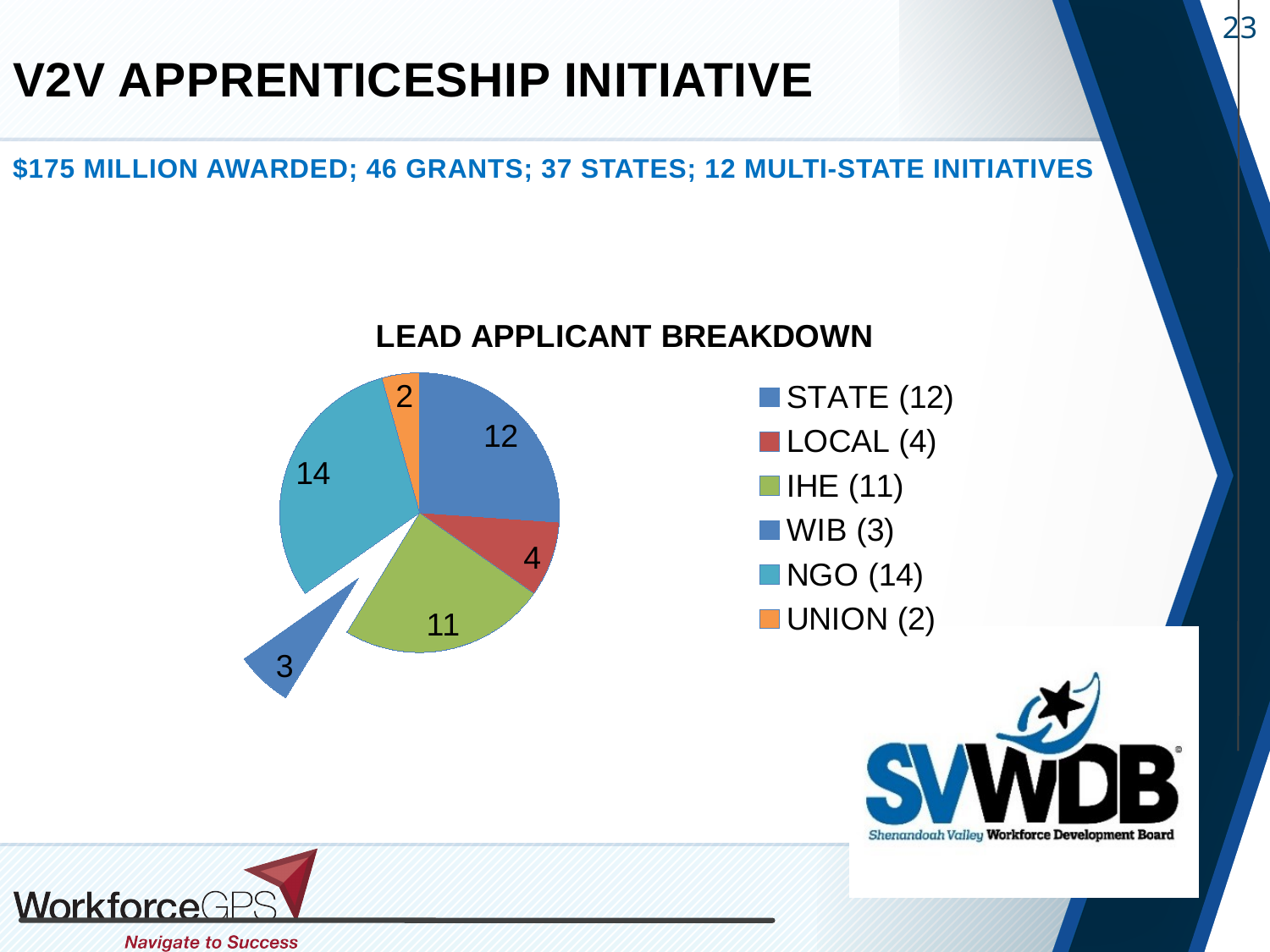
What is the total of all slices in the Lead Applicant Breakdown pie chart? 46 What is the difference between the NGO and STATE values in the Lead Applicant Breakdown pie chart? 2 What is the difference between the IHE and LOCAL values in the Lead Applicant Breakdown pie chart? 7 Which slice is pulled out (exploded) from the Lead Applicant Breakdown pie chart? WIB (3) What is the value for IHE in the Lead Applicant Breakdown pie chart? 11 Which is larger in the Lead Applicant Breakdown pie chart, LOCAL or WIB? LOCAL What is the value for NGO in the Lead Applicant Breakdown pie chart? 14 What type of chart is shown under the title "LEAD APPLICANT BREAKDOWN"? Pie chart Which category has the smallest slice in the Lead Applicant Breakdown pie chart? UNION What is the value for WIB in the Lead Applicant Breakdown pie chart? 3 How many categories are shown in the Lead Applicant Breakdown pie chart? 6 Which category has the largest slice in the Lead Applicant Breakdown pie chart? NGO